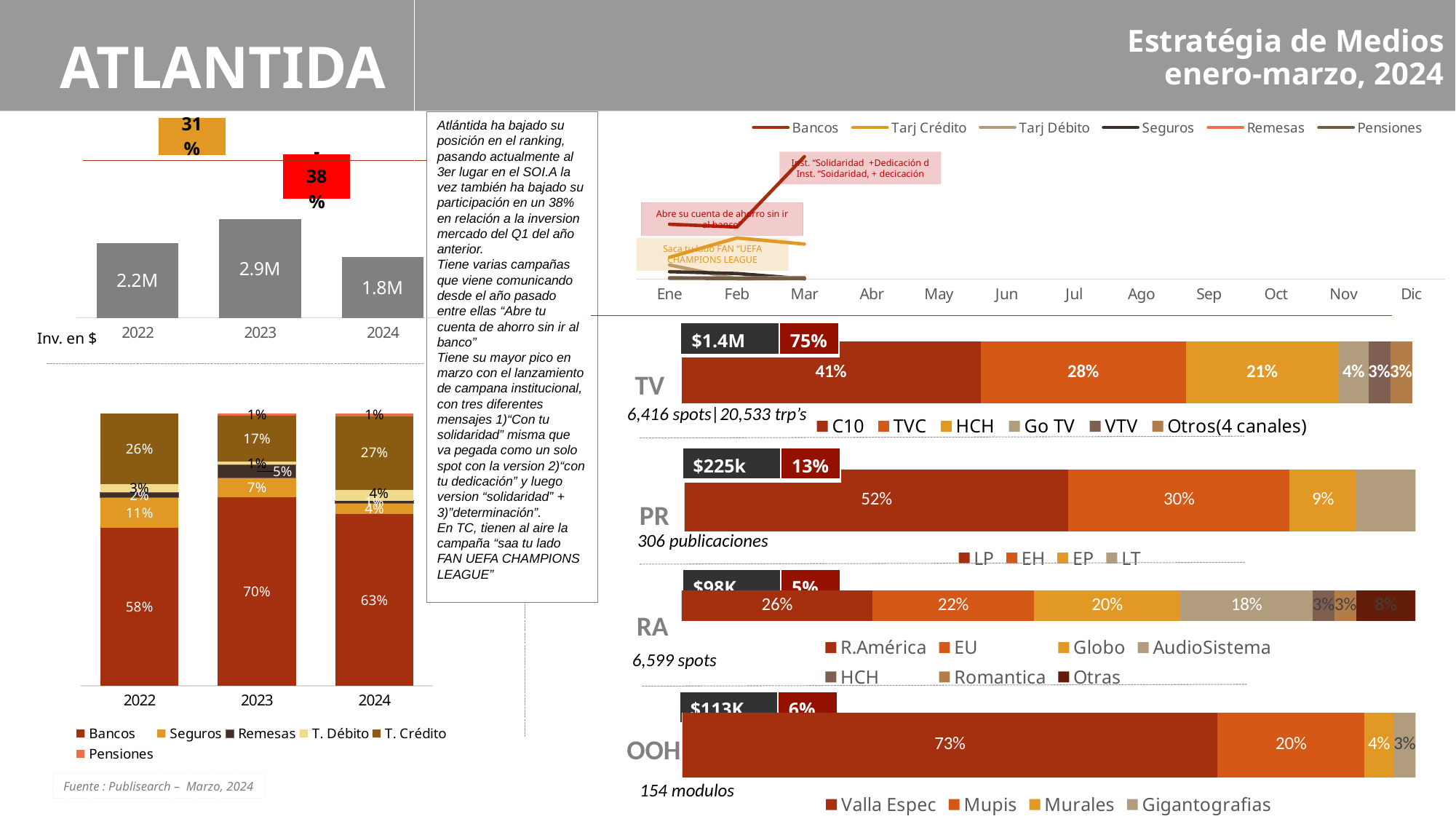
In the 'Inv. en $' bar chart at the top left, which year has the lowest investment? 2024 In the PR bar on the right, which outlet has the largest share? LP In the 'Inv. en $' bar chart at the top left, how many years are shown? 3 In the stacked bar chart at the bottom left, what is the share of T. Crédito in 2024? 27% In the TV bar on the right, what is the share for C10? 41% In the 'Inv. en $' bar chart at the top left, what is the value for 2023? 2.9M In the stacked bar chart at the bottom left, how many series does the legend list? 6 In the stacked bar chart at the bottom left, what is the share of Bancos in 2023? 70% In the TV bar on the right, what is the difference between the shares of C10 and TVC? 13% In the OOH bar on the right, what is the share for Mupis? 20% In the line chart at the top right, how many series does the legend list? 6 In the RA bar on the right, which is larger, the share for EU or the share for Globo? EU